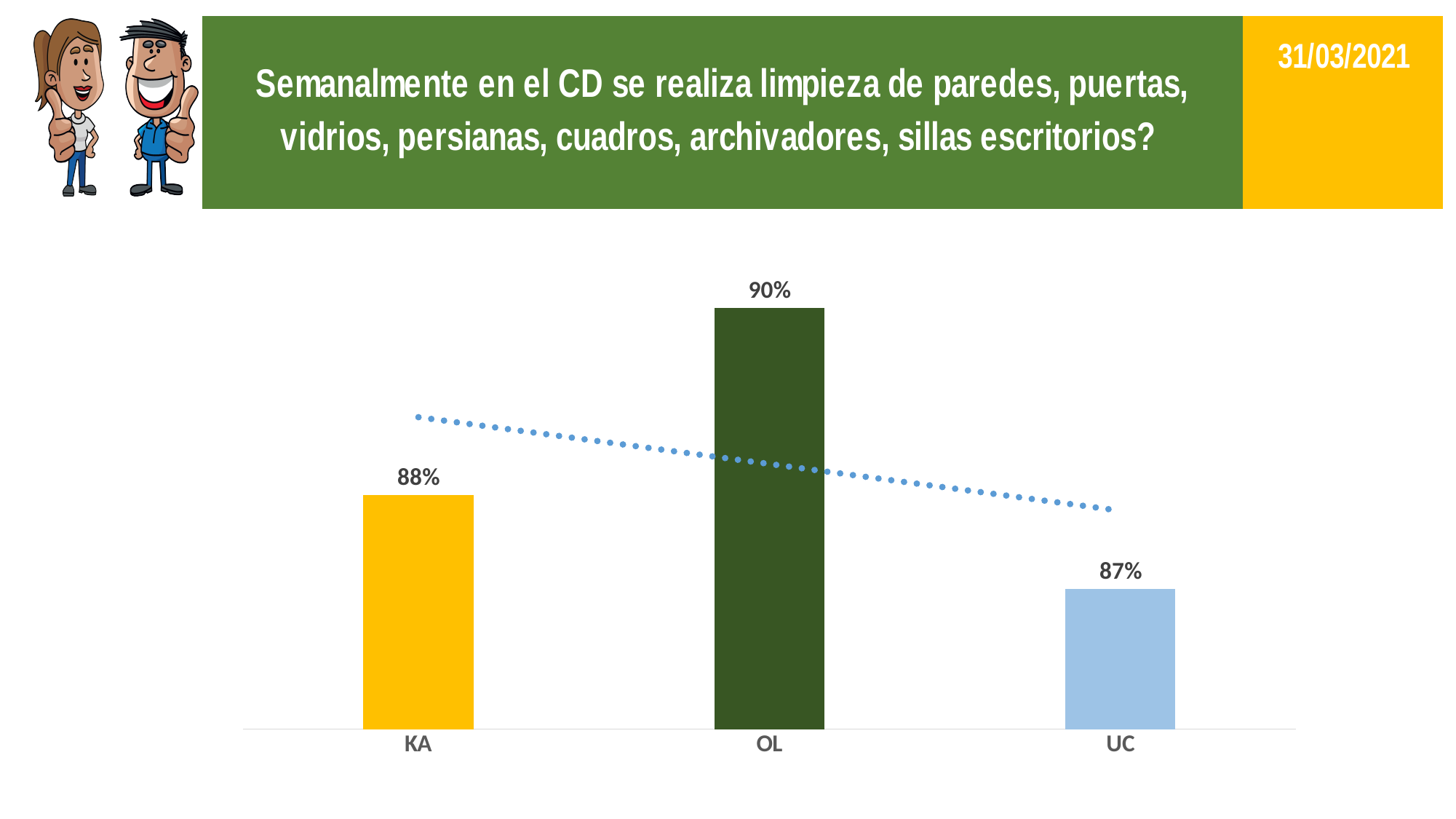
What is the difference between the values for KA and UC? 1% Which category has the lowest value? UC What is the value for OL? 90% Which is larger, the value for OL or the value for KA? OL How many categories are shown on the x axis? 3 What colour is the bar for OL? dark green What is the difference between the values for OL and UC? 3% What date is shown in the top right corner of the slide? 31/03/2021 What is the value for KA? 88% Which category has the highest value? OL What is the value for UC? 87% What kind of chart is shown on the slide? bar chart